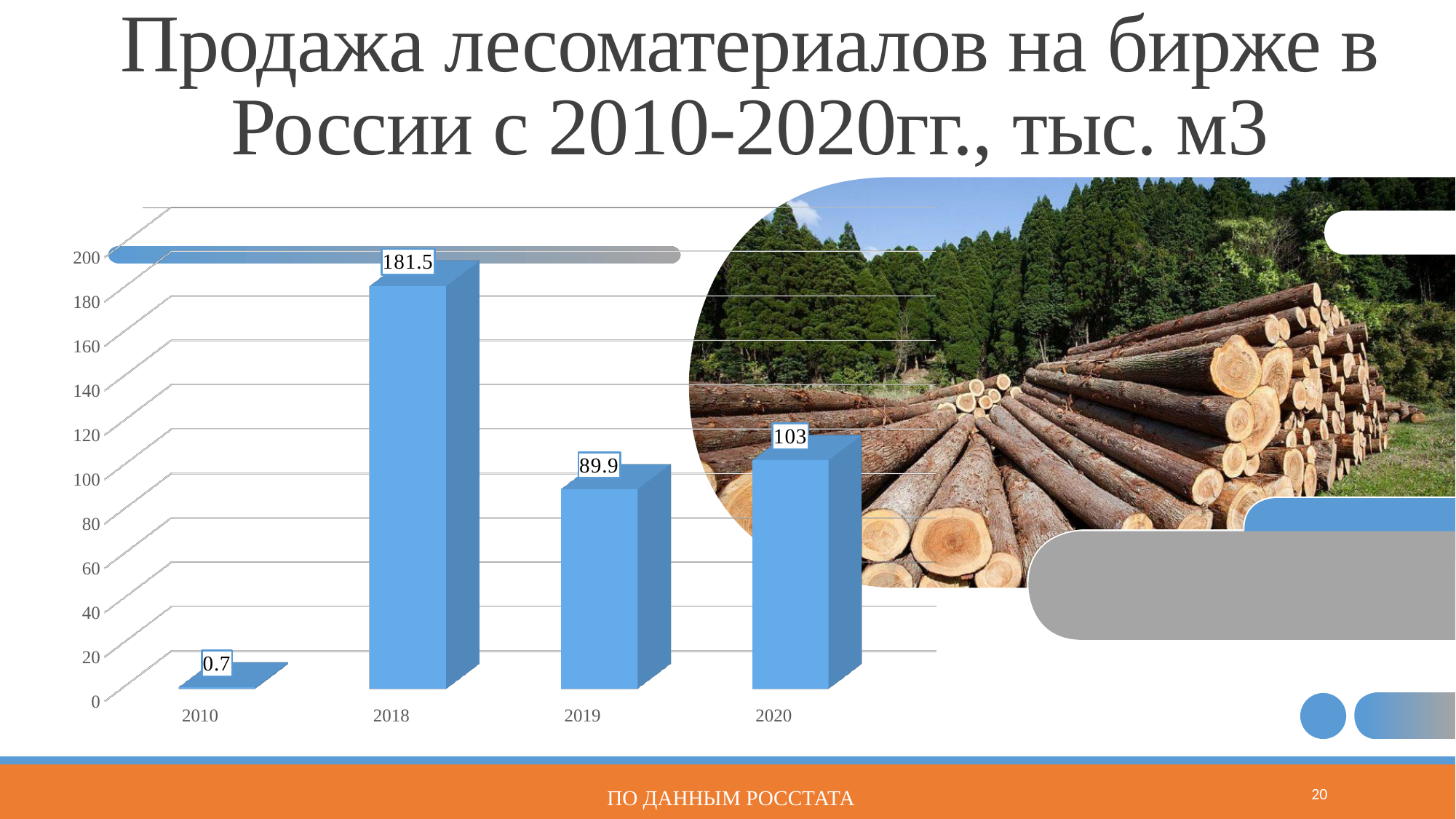
What is the value for 2019? 89.9 What kind of chart is shown on the slide? bar chart What is the difference between the values for 2018 and 2020? 78.5 What is the value for 2020? 103 Is the value for 2019 greater or less than 100? less Which year has the highest value? 2018 What is the value for 2010? 0.7 How many years are shown on the x axis? 4 Which year has the lowest value? 2010 What is the value for 2018? 181.5 Which is larger, the value for 2019 or the value for 2020? 2020 What is the difference between the values for 2020 and 2019? 13.1